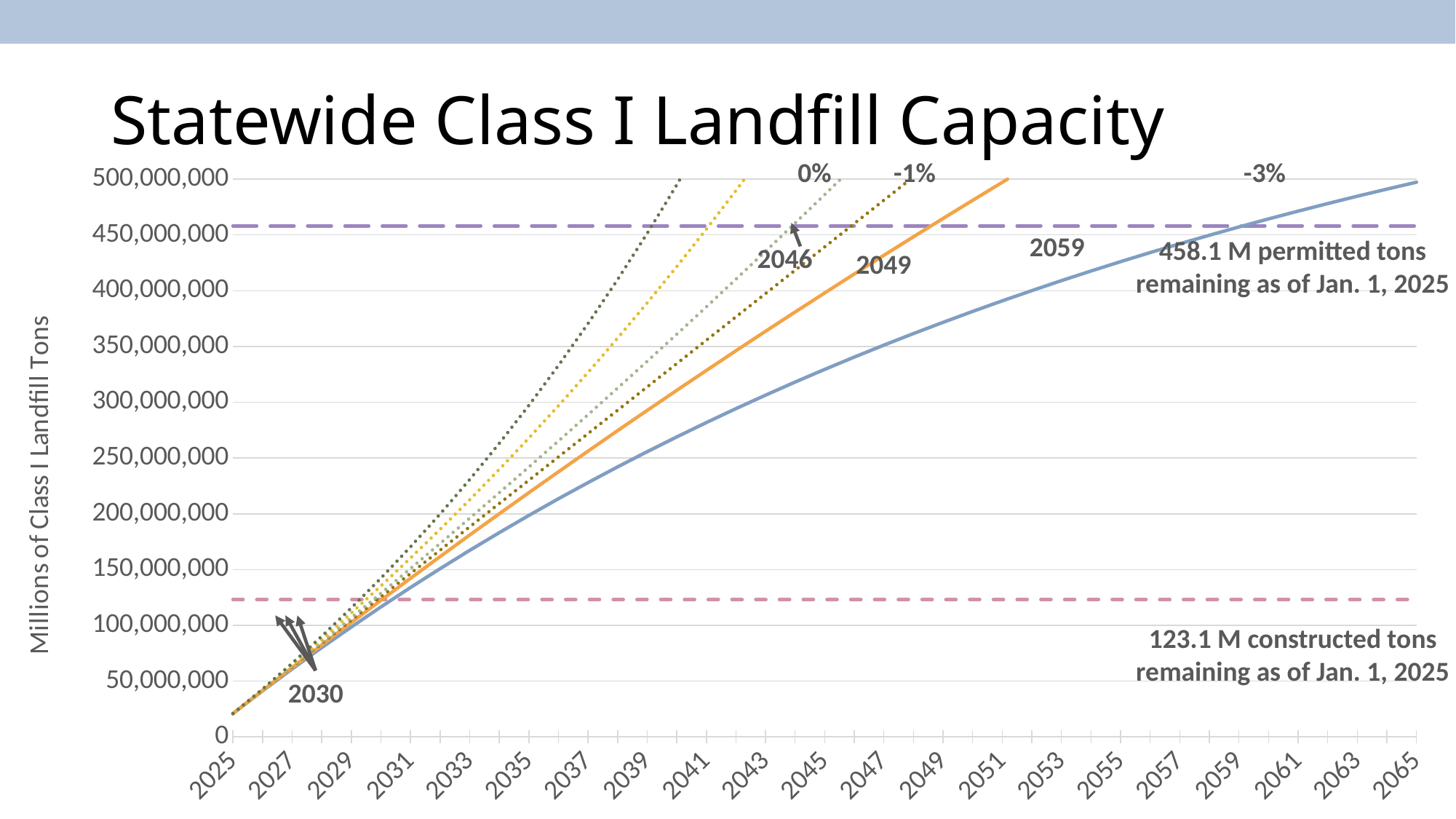
How many permitted tons were remaining as of Jan. 1, 2025, according to the chart annotation? 458.1 M In 2045, which line is higher: the orange solid line or the blue solid line? the orange solid line Do the scenario lines rise or fall as the years increase along the x axis? rise In what year does the 0% scenario line reach the permitted capacity line? 2046 What year is annotated near the point where the scenario lines begin to diverge? 2030 What is the title of the chart? Statewide Class I Landfill Capacity Is the value of the blue solid line in 2057 greater or less than 400,000,000? greater How many constructed tons were remaining as of Jan. 1, 2025, according to the chart annotation? 123.1 M What is the label on the vertical axis of the chart? Millions of Class I Landfill Tons In what year does the -3% scenario line reach the permitted capacity line? 2059 Is the value of the blue solid line in 2041 greater or less than 300,000,000? less What type of chart is shown on the slide? line chart